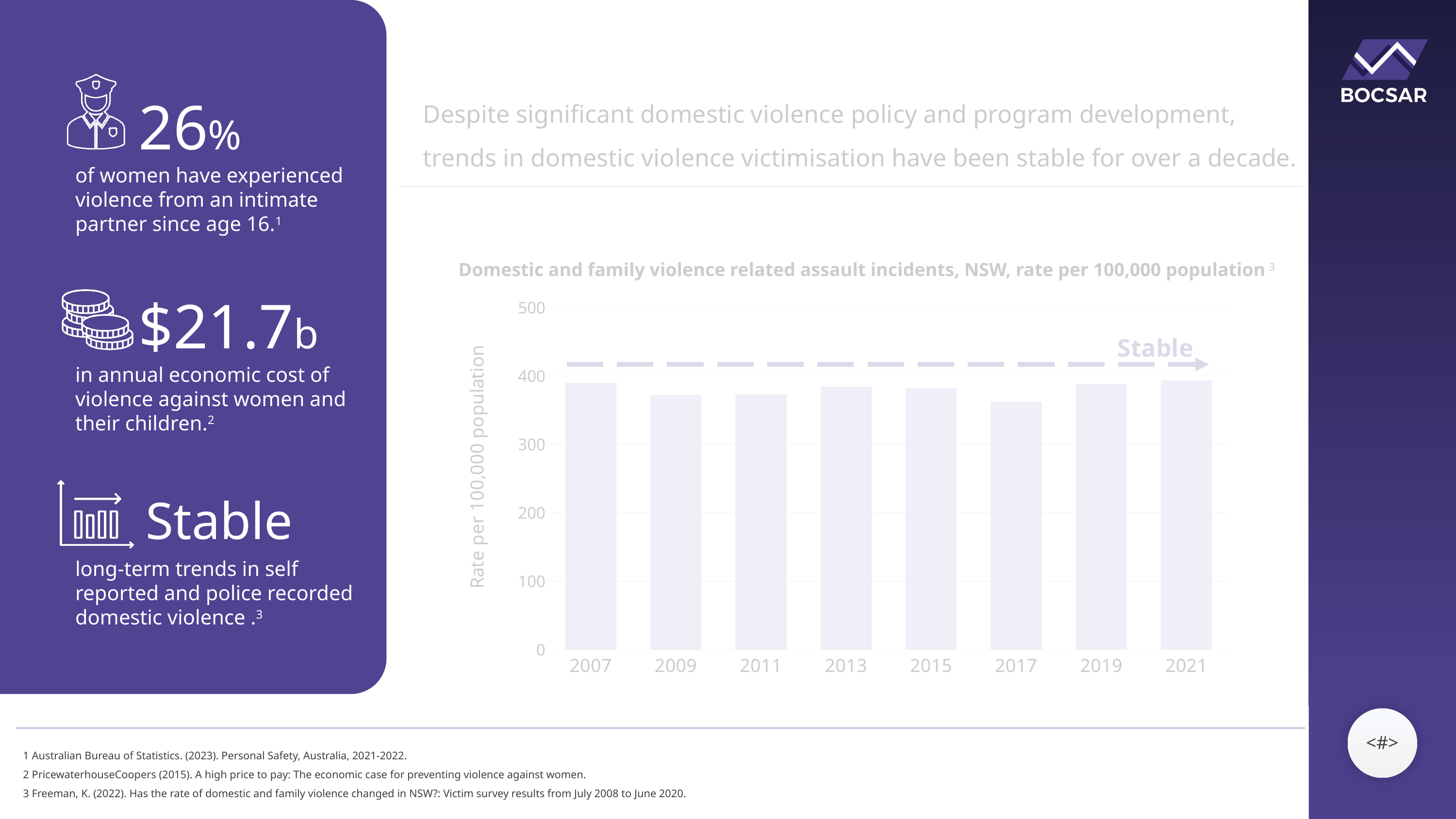
Is the value for 2013 greater or less than 300? greater What kind of chart is shown on the slide? bar chart Is the value for 2007 greater or less than 400? less What is the title of the chart? Domestic and family violence related assault incidents, NSW, rate per 100,000 population How many years are plotted on the chart? 8 Is the value for 2017 greater or less than 300? greater What is the label on the vertical axis of the chart? Rate per 100,000 population Which is larger, the value for 2017 or the value for 2021? 2021 Do the values rise, fall, or stay stable from 2007 to 2021? stable Which year has the lowest value on the chart? 2017 Which is larger, the value for 2007 or the value for 2017? 2007